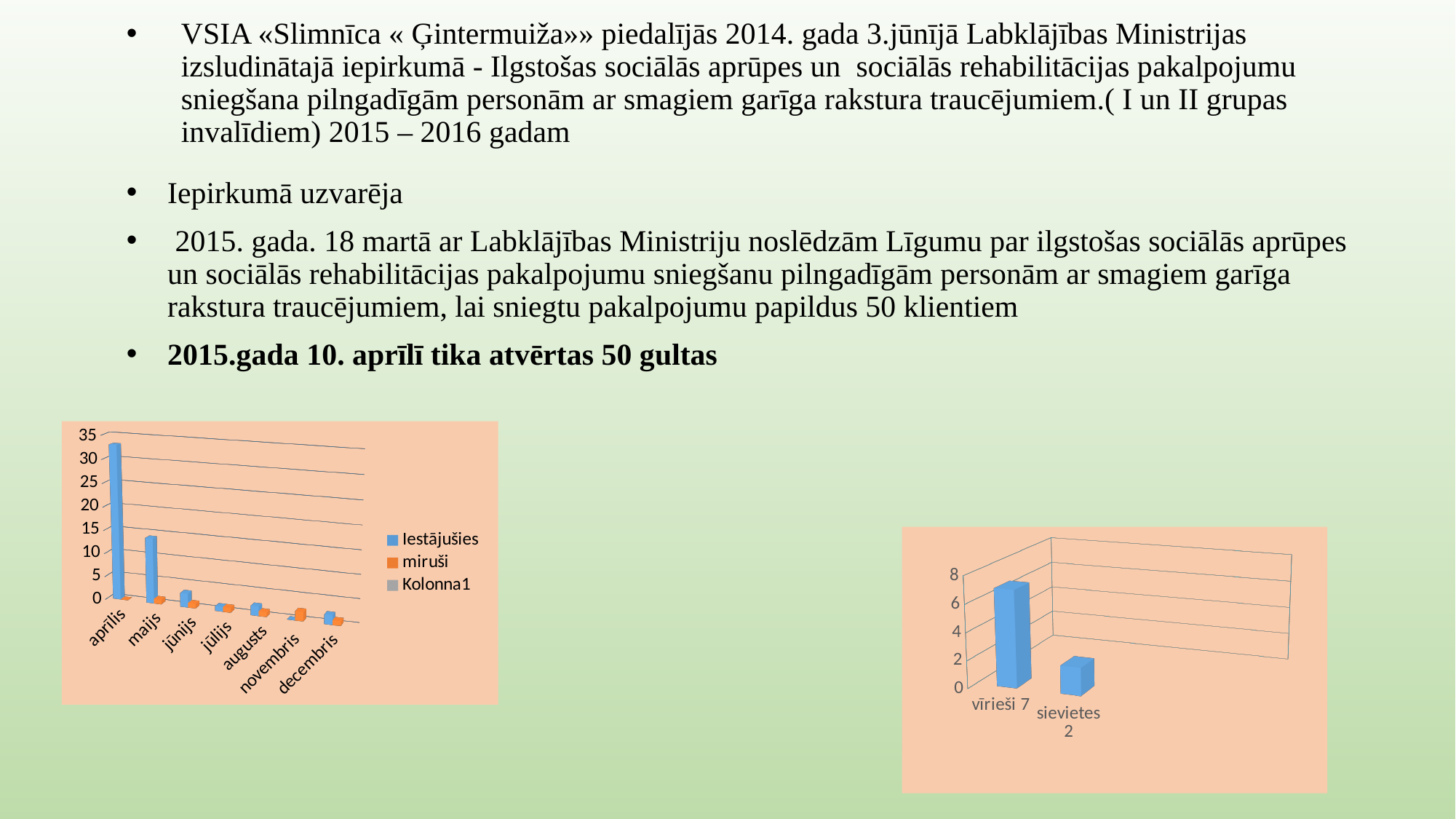
In the left chart, is the Iestājušies value for maijs greater or less than 10? greater In the left chart, is the Iestājušies value for jūnijs greater or less than 5? less In the right chart, what is the value for sievietes? 2 In the left chart, is the Iestājušies value for aprīlis greater or less than 30? greater In the left chart, which series is shown in orange in the legend? miruši In the right chart, what is the value for vīrieši? 7 In the left chart, which month has the highest value for Iestājušies? aprīlis In the left chart, do the Iestājušies values rise or fall from aprīlis to decembris? fall In the left chart, how many series does the legend list? 3 In the left chart, how many months are shown on the x axis? 7 In the left chart, what kind of chart is shown? bar chart In the right chart, what is the difference between the values for vīrieši and sievietes? 5